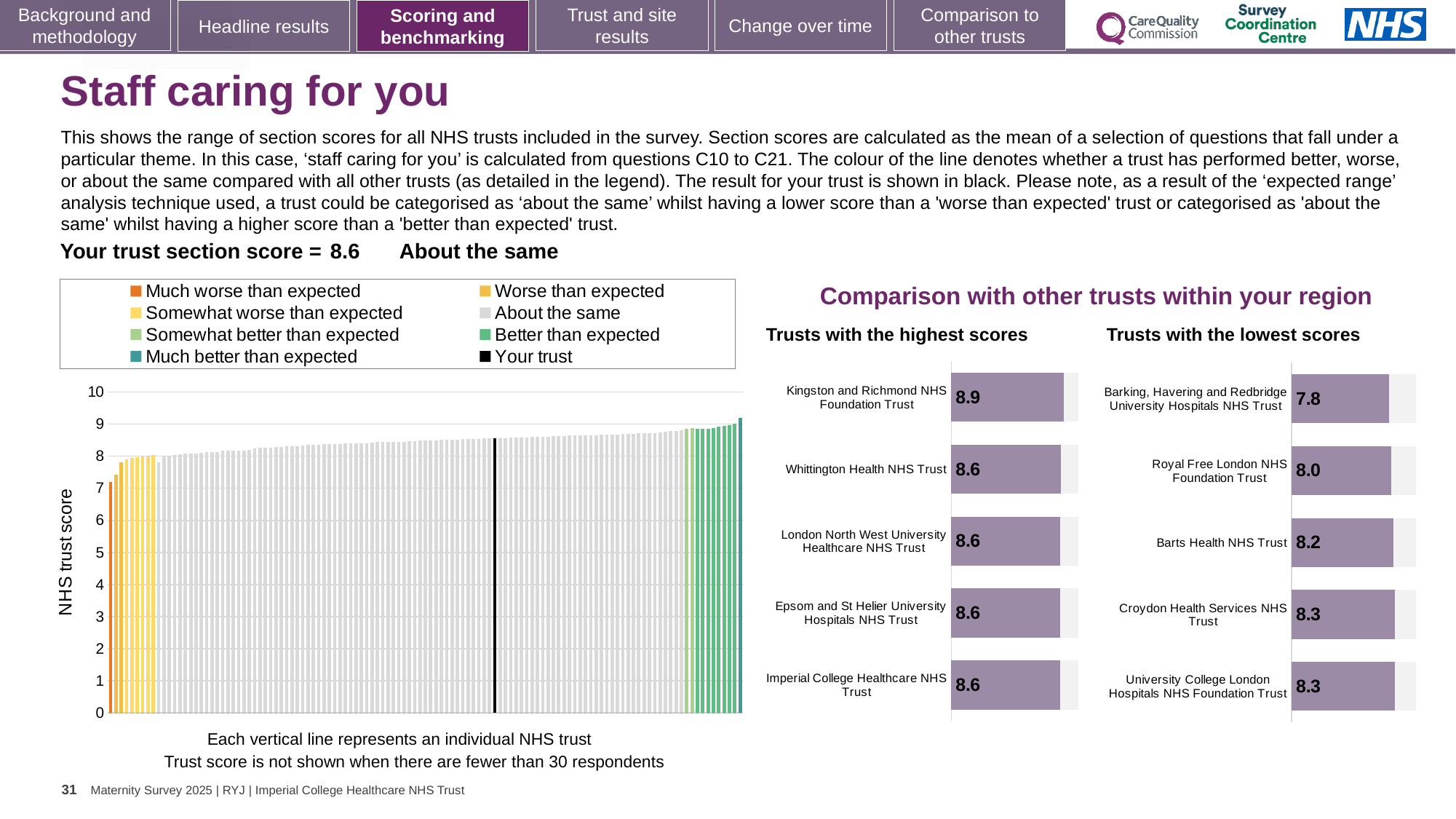
In the large 'NHS trust score' chart on the left, is the value of the leftmost (orange) bar greater or less than 8? less How many entries does the legend above the large 'NHS trust score' chart list? 8 In the 'Trusts with the lowest scores' chart, what is the score for Barking, Havering and Redbridge University Hospitals NHS Trust? 7.8 In the 'Trusts with the lowest scores' chart, what is the score for Barts Health NHS Trust? 8.2 In the 'Trusts with the lowest scores' chart, which has the larger score: Royal Free London NHS Foundation Trust or Barts Health NHS Trust? Barts Health NHS Trust What is the difference between the score for Kingston and Richmond NHS Foundation Trust in the highest scores chart and the score for Barking, Havering and Redbridge University Hospitals NHS Trust in the lowest scores chart? 1.1 In the 'Trusts with the highest scores' chart, which trust has the highest score? Kingston and Richmond NHS Foundation Trust In the large 'NHS trust score' chart on the left, do the bar values rise or fall from left to right? rise In the 'Trusts with the lowest scores' chart, which trust has the lowest score? Barking, Havering and Redbridge University Hospitals NHS Trust In the 'Trusts with the highest scores' chart, what is the score for Kingston and Richmond NHS Foundation Trust? 8.9 How many trusts are shown in the 'Trusts with the highest scores' chart? 5 What kind of chart is the large 'NHS trust score' chart on the left? bar chart